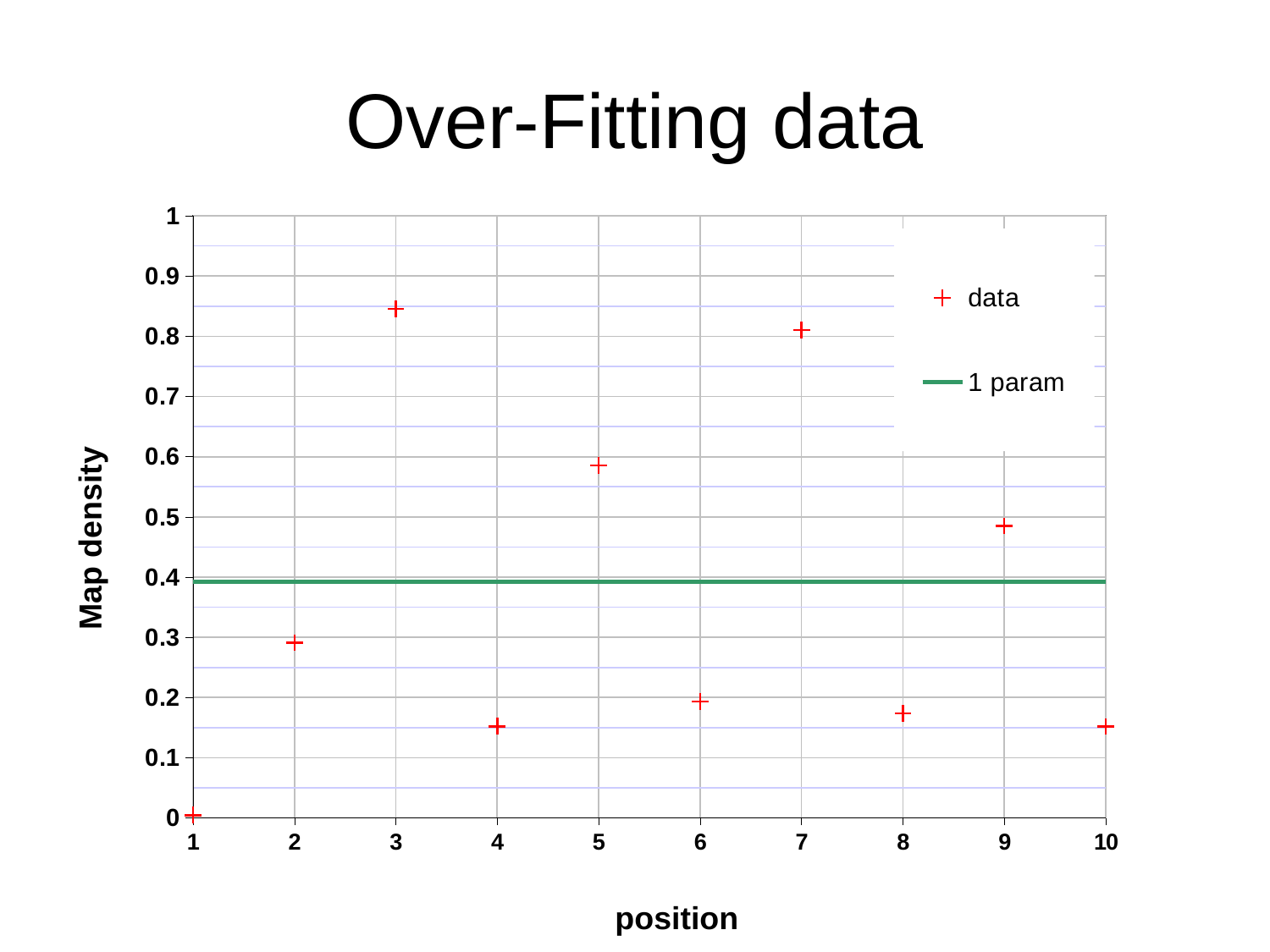
How many data points are plotted for the 'data' series? 10 At which position is the Map density of the 'data' series highest? 3 Is the Map density of the 'data' series at position 3 greater or less than 0.8? greater Is the Map density of the 'data' series at position 5 greater or less than 0.5? greater How many series does the legend list? 2 What kind of chart is shown on the slide? scatter chart What is the title of the chart? Over-Fitting data At which position is the Map density of the 'data' series lowest? 1 Which has the larger Map density in the 'data' series: position 5 or position 9? position 5 What is the label of the x axis? position Is the Map density of the 'data' series at position 4 greater or less than 0.2? less